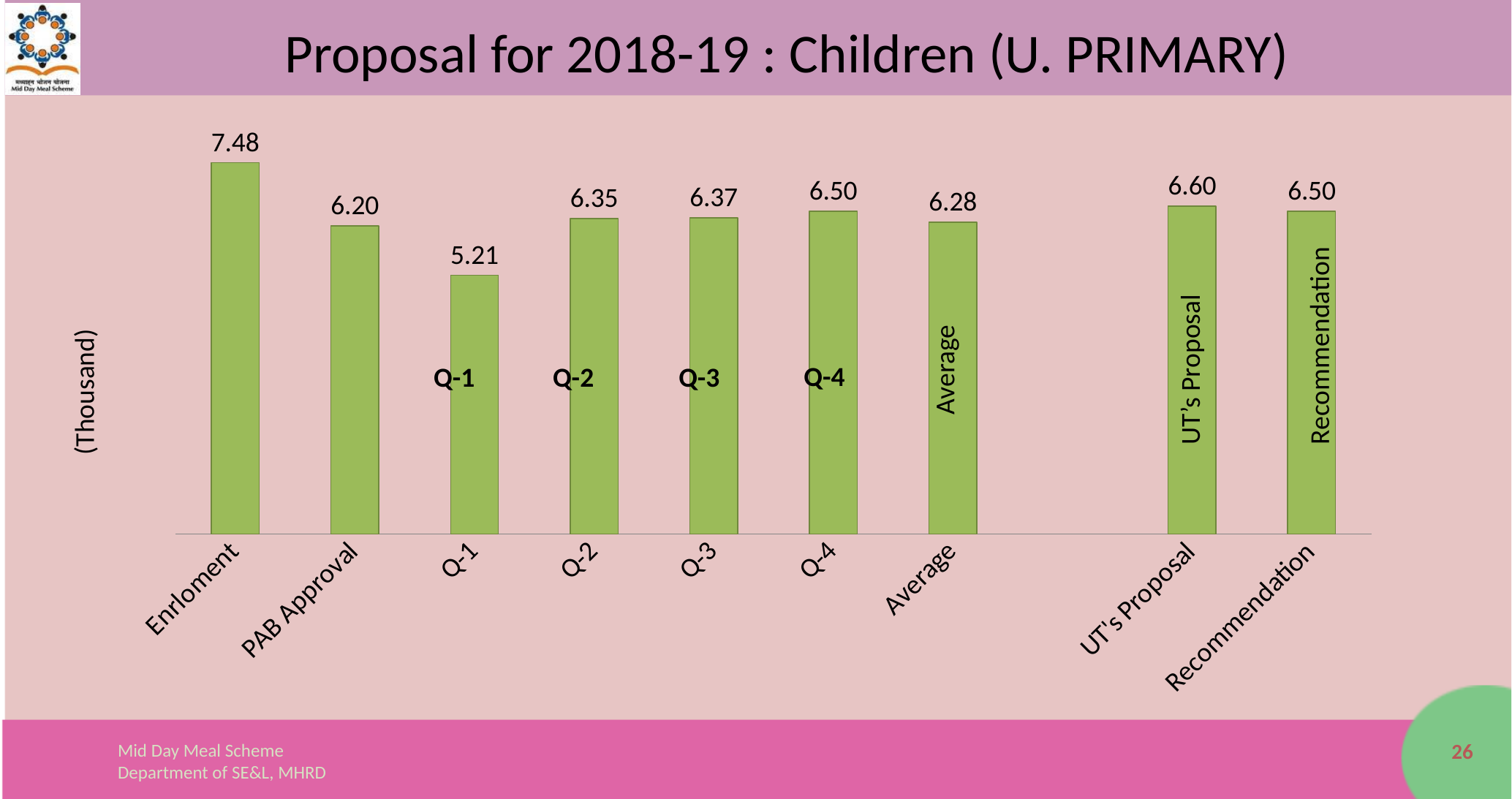
How many bars are shown in the chart? 9 What is the difference between the Enrolment value and the PAB Approval value? 1.28 What is the value for UT's Proposal? 6.60 What kind of chart is shown on the slide? Bar chart Which category has the lowest value? Q-1 What is the value for Q-1? 5.21 Which is larger, the value for Q-4 or the value for Q-1? Q-4 What unit is indicated on the vertical axis label? (Thousand) What is the value for Enrolment? 7.48 What is the difference between the UT's Proposal value and the Recommendation value? 0.10 Which category has the highest value? Enrolment What is the value for PAB Approval? 6.20